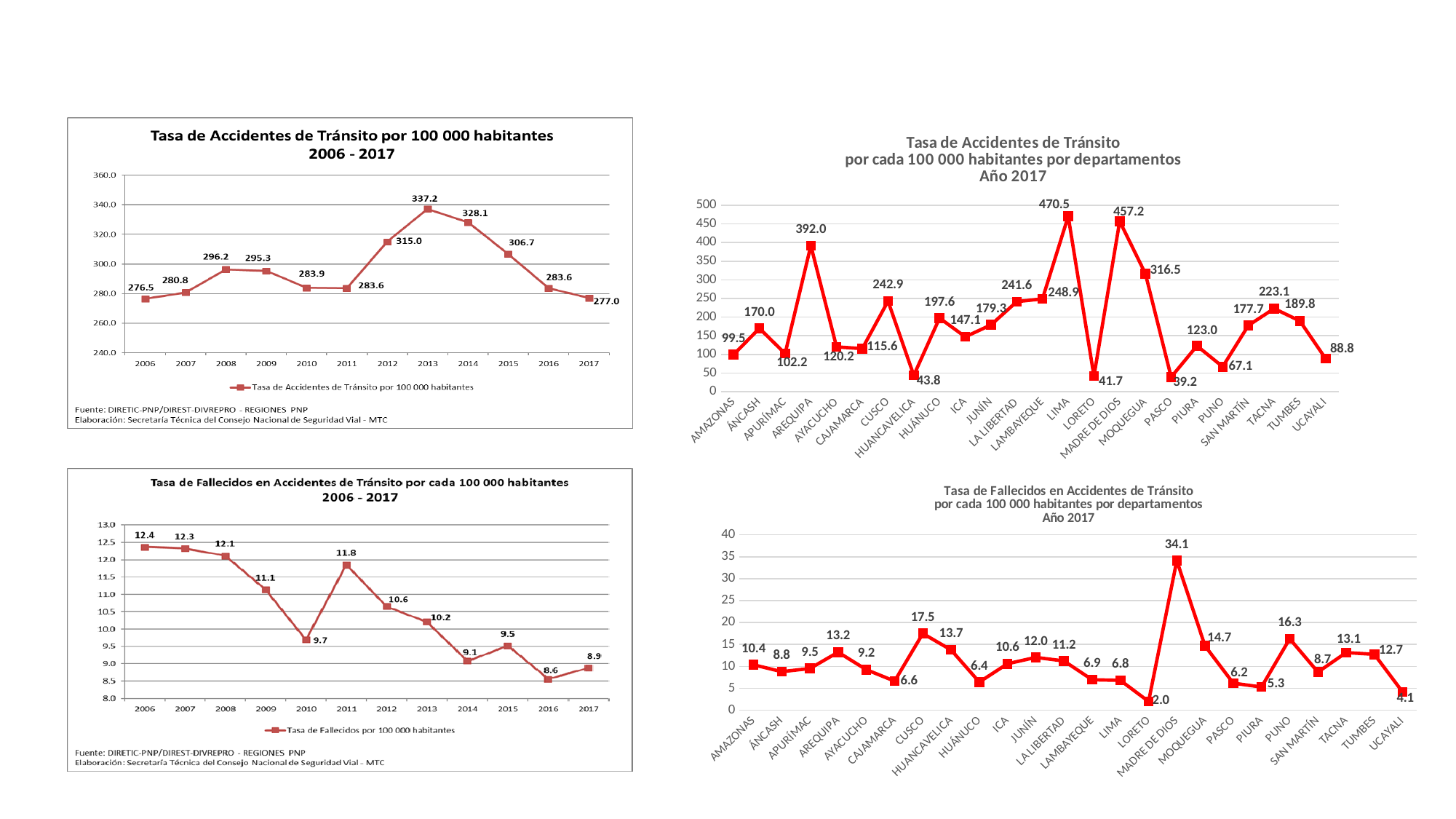
In the bottom-left chart (Tasa de Fallecidos en Accidentes de Tránsito 2006 - 2017), what kind of chart is shown? Line chart In the top-right chart (Tasa de Accidentes de Tránsito por departamentos Año 2017), what is the value for AREQUIPA? 392.0 In the top-right chart (Tasa de Accidentes de Tránsito por departamentos Año 2017), which department has the lowest value? PASCO In the bottom-left chart (Tasa de Fallecidos en Accidentes de Tránsito 2006 - 2017), what is the value for 2010? 9.7 In the bottom-right chart (Tasa de Fallecidos en Accidentes de Tránsito por departamentos Año 2017), which is larger, the value for CUSCO or the value for PUNO? CUSCO In the top-right chart (Tasa de Accidentes de Tránsito por departamentos Año 2017), which department has the highest value? LIMA In the bottom-right chart (Tasa de Fallecidos en Accidentes de Tránsito por departamentos Año 2017), what is the value for MADRE DE DIOS? 34.1 In the bottom-left chart (Tasa de Fallecidos en Accidentes de Tránsito 2006 - 2017), which year has the highest value? 2006 In the top-left chart (Tasa de Accidentes de Tránsito por 100 000 habitantes 2006 - 2017), what is the value for 2013? 337.2 In the top-left chart (Tasa de Accidentes de Tránsito por 100 000 habitantes 2006 - 2017), what is the difference between the 2013 value and the 2017 value? 60.2 In the top-left chart (Tasa de Accidentes de Tránsito por 100 000 habitantes 2006 - 2017), which year has the lowest value? 2006 In the top-right chart (Tasa de Accidentes de Tránsito por departamentos Año 2017), how many departments are plotted? 24